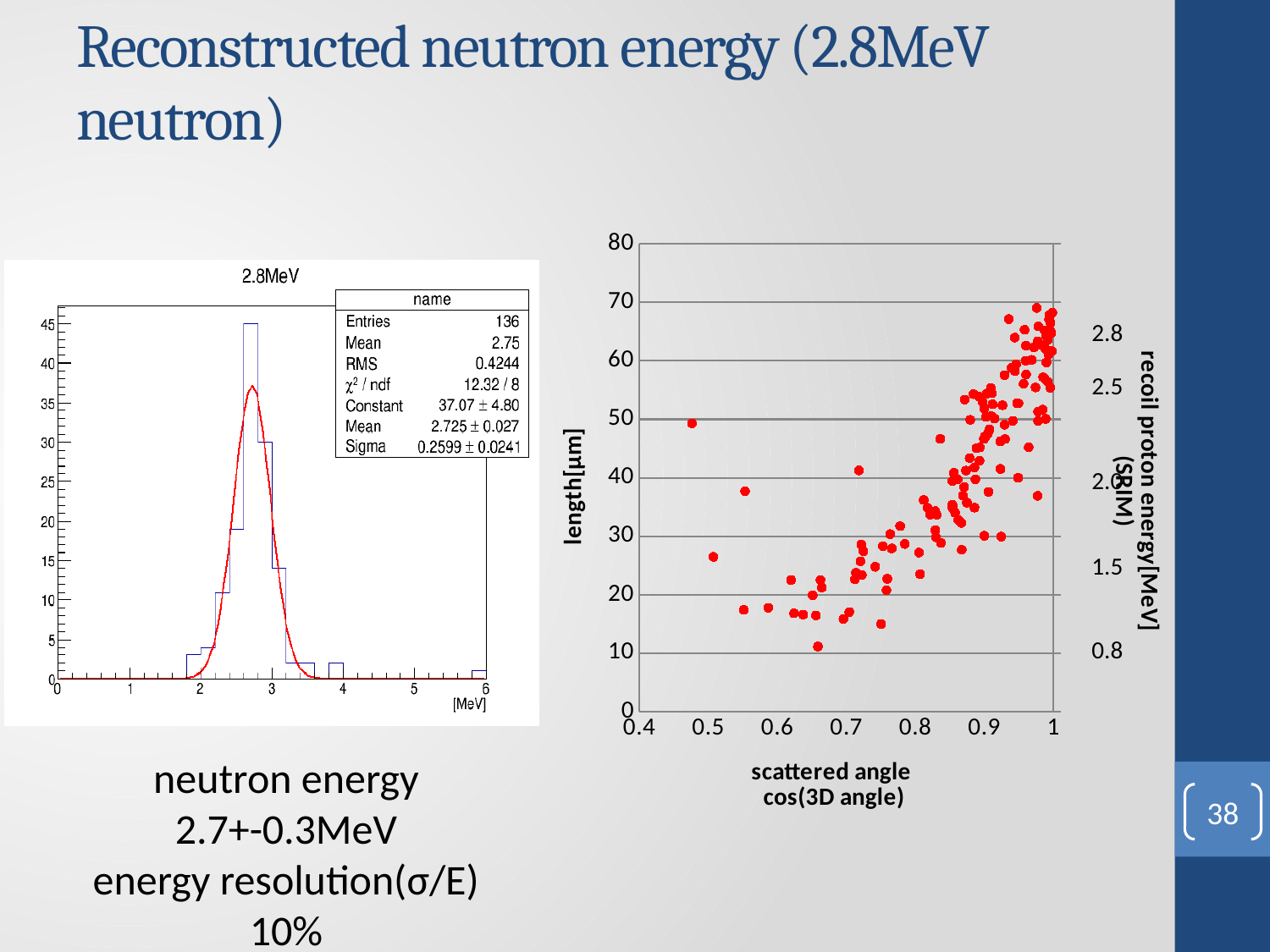
In the left histogram, is the height of the tallest bin greater or less than 40? greater What kind of chart is the right-hand chart of length[μm] versus scattered angle? scatter chart In the right scatter chart, is the length of the lowest point (near cos(3D angle) 0.66) greater or less than 20? less What is the title shown above the left histogram? 2.8MeV In the left histogram's statistics box, what is the χ² / ndf value? 12.32 / 8 What is the x-axis title of the right scatter chart? scattered angle cos(3D angle) In the left histogram's statistics box, what is the fitted Constant value? 37.07 ± 4.80 In the left histogram's statistics box, what is the RMS value? 0.4244 In the right scatter chart, does the length generally rise or fall as cos(3D angle) increases from 0.6 to 1? rise In the left histogram's statistics box, what is the fitted Sigma value? 0.2599 ± 0.0241 In the left histogram's statistics box, how many entries are listed? 136 In the right scatter chart, is the length of the highest point (near cos(3D angle) 1) greater or less than 60? greater